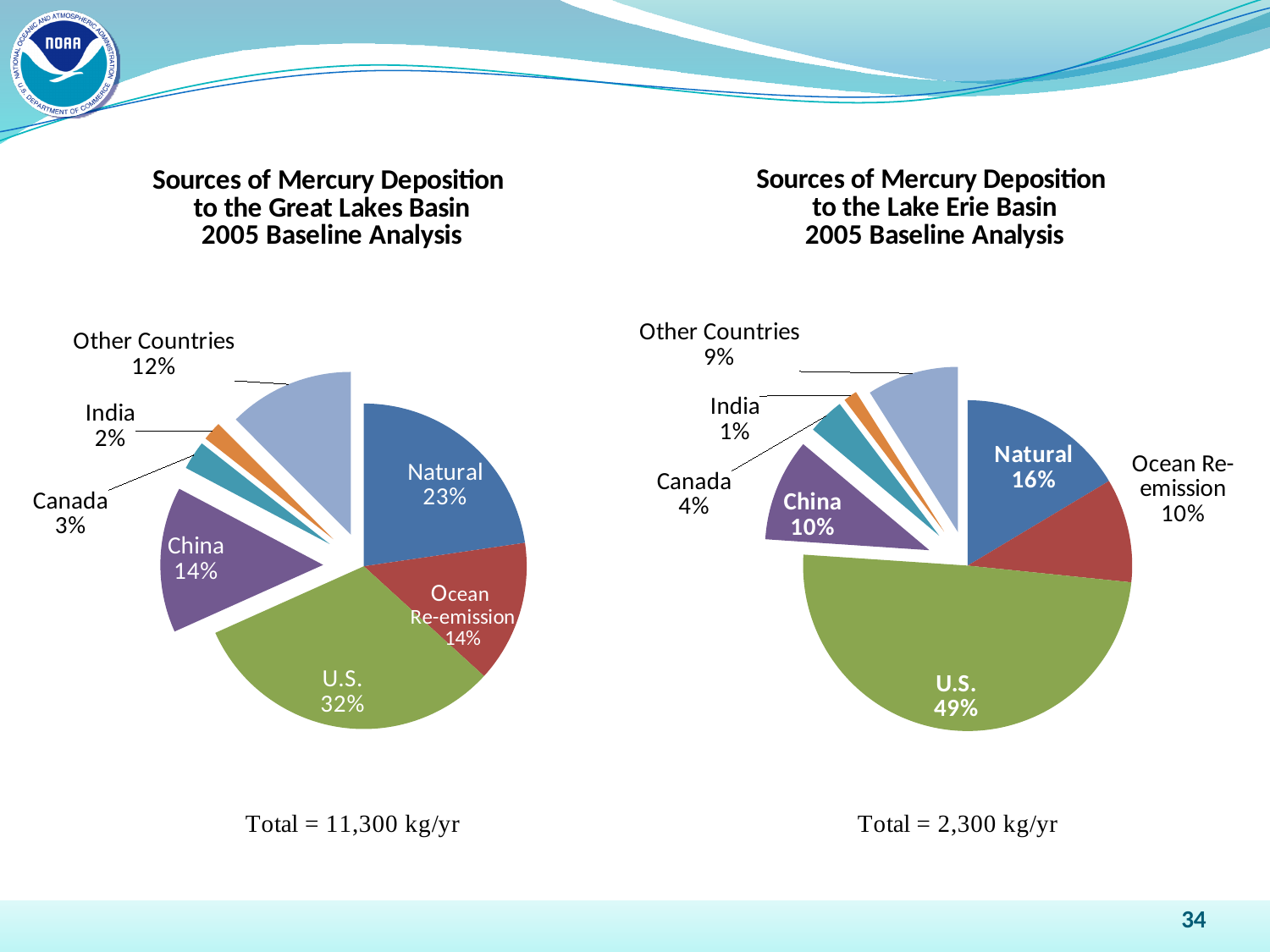
In the Lake Erie Basin pie chart, what is the combined share of Canada and India? 5% In the Great Lakes Basin pie chart, which source has the largest share? U.S. What total deposition is stated below the Great Lakes Basin pie chart? 11,300 kg/yr In the Lake Erie Basin pie chart, which source has the smallest share? India In the Great Lakes Basin pie chart, what share of mercury deposition comes from the U.S.? 32% In the Great Lakes Basin pie chart, what share comes from Other Countries? 12% What kind of chart is used for the Lake Erie Basin data? Pie chart What total deposition is stated below the Lake Erie Basin pie chart? 2,300 kg/yr How many slices does the Great Lakes Basin pie chart have? 7 In the Great Lakes Basin pie chart, what is the difference between the Natural share and the China share? 9% In the Lake Erie Basin pie chart, what share of mercury deposition comes from China? 10% In the Lake Erie Basin pie chart, which is larger, the Natural share or the Ocean Re-emission share? Natural